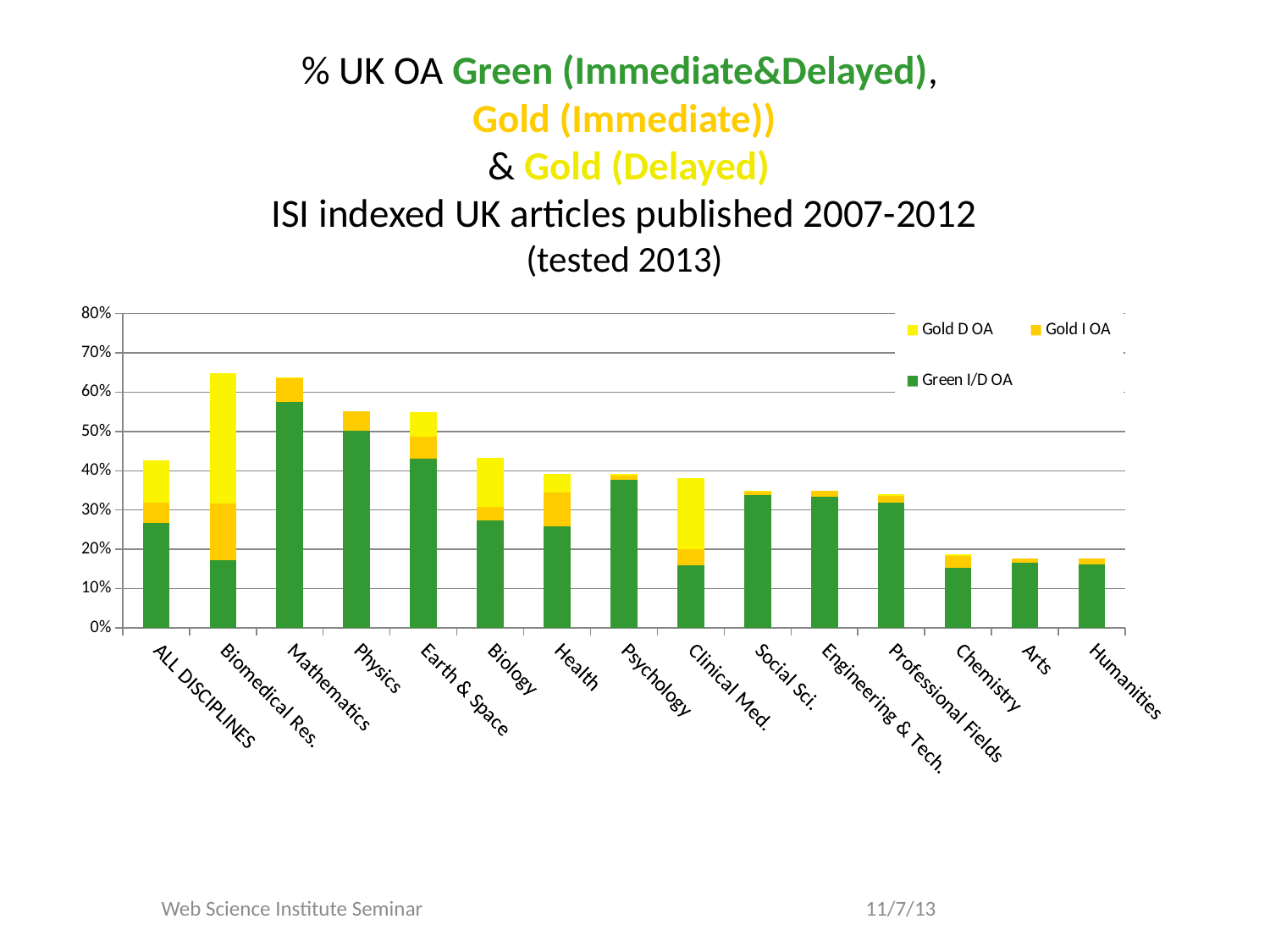
What kind of chart is shown on the slide? stacked bar chart Is the Green I/D OA value for Biomedical Res. greater or less than 20%? less Which category has the tallest green (Green I/D OA) segment? Mathematics Which has the larger Gold D OA segment, Biomedical Res. or Social Sci.? Biomedical Res. Do the total bar heights generally rise or fall moving from Mathematics to Humanities along the x axis? fall Is the Green I/D OA value for Health greater or less than 30%? less How many series does the chart legend list? 3 Is the total stacked bar for Chemistry greater or less than 20%? less Which has the larger Green I/D OA segment, Physics or Biology? Physics How many discipline categories are shown on the x axis of the chart? 15